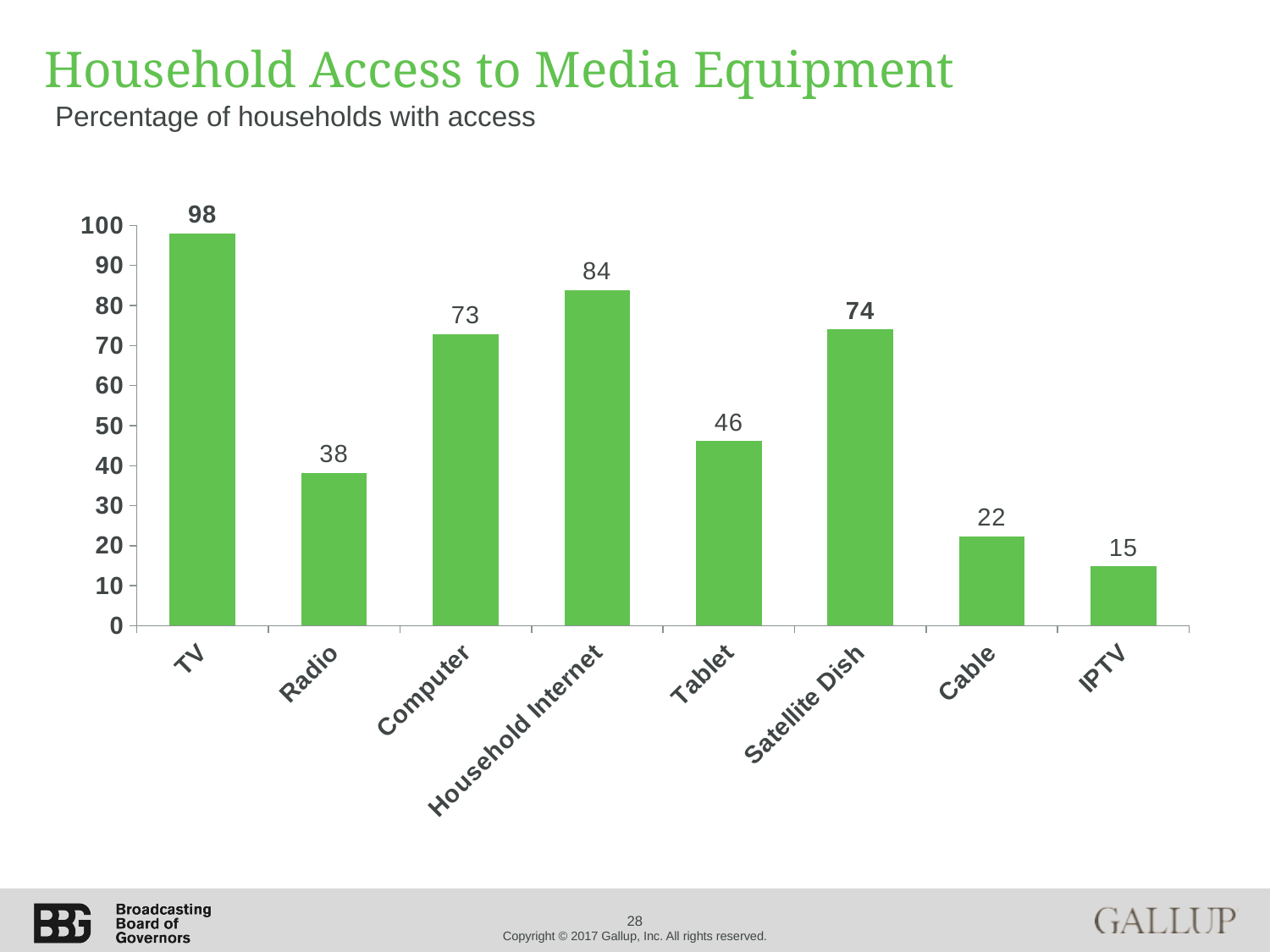
What is the title of the chart? Household Access to Media Equipment Which category has the lowest value? IPTV Which category has the highest value? TV What kind of chart is shown on the slide? bar chart Which is larger, the value for Tablet or the value for Radio? Tablet What is the difference between the values for Computer and Radio? 35 How many categories are shown on the chart? 8 What percentage of households have access to TV? 98 Is the value for Tablet greater or less than 50? less What is the value shown for Satellite Dish? 74 What is the difference between the values for Cable and IPTV? 7 What is the value shown for Household Internet? 84